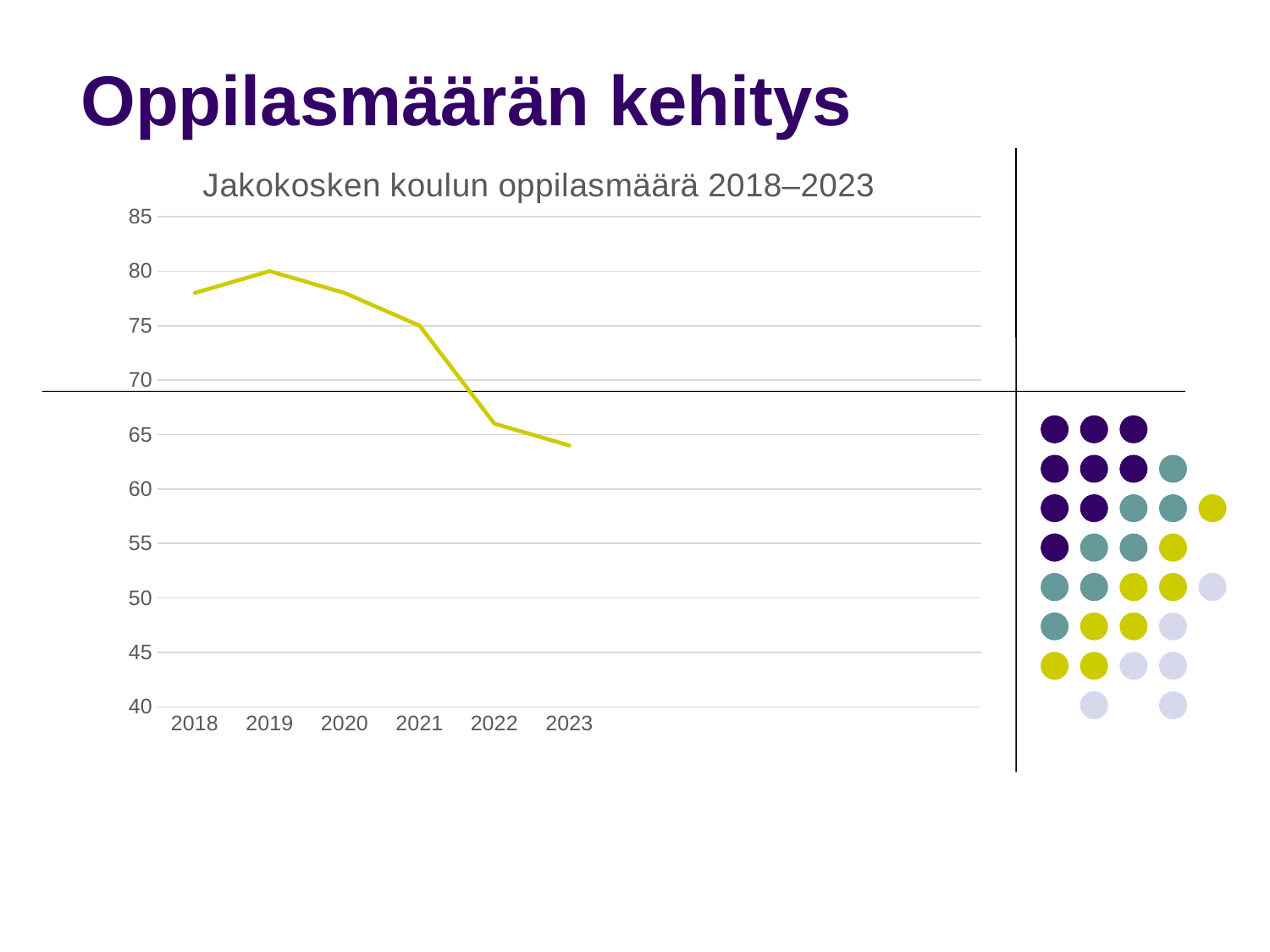
What is the title of the chart? Jakokosken koulun oppilasmäärä 2018–2023 Is the value for 2018 greater or less than 75? greater How many years are plotted on the x axis of the chart? 6 What type of chart is shown on the slide? line chart Do the values generally rise or fall from 2019 to 2023? fall What is the value for 2019? 80 Which year has the lowest value? 2023 Is the value for 2022 greater or less than 70? less What is the value for 2021? 75 What is the difference between the values for 2019 and 2021? 5 Which year has the highest value? 2019 Which is larger, the value for 2020 or the value for 2023? 2020